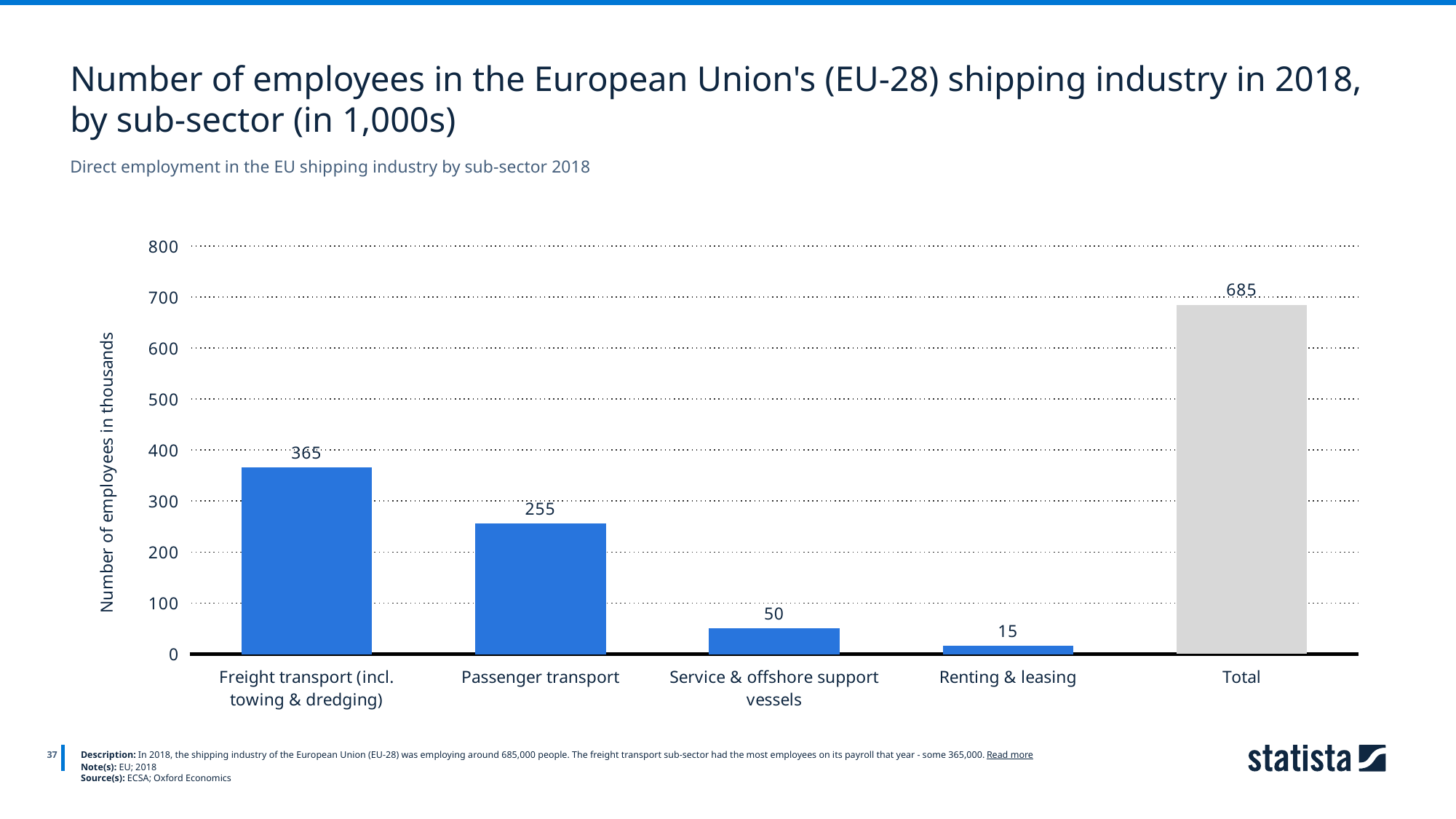
Which category has the lowest value? Renting & leasing What is the value for Service & offshore support vessels? 50 Excluding the Total bar, which sub-sector has the highest number of employees? Freight transport (incl. towing & dredging) What is the label of the vertical axis? Number of employees in thousands What is the value for Freight transport (incl. towing & dredging)? 365 How many bars are shown in the chart? 5 What is the difference between the values for Freight transport (incl. towing & dredging) and Passenger transport? 110 What is the value for Total? 685 What is the value for Renting & leasing? 15 Which is larger, the value for Service & offshore support vessels or the value for Renting & leasing? Service & offshore support vessels What kind of chart is shown on the slide? Bar chart What is the value for Passenger transport? 255